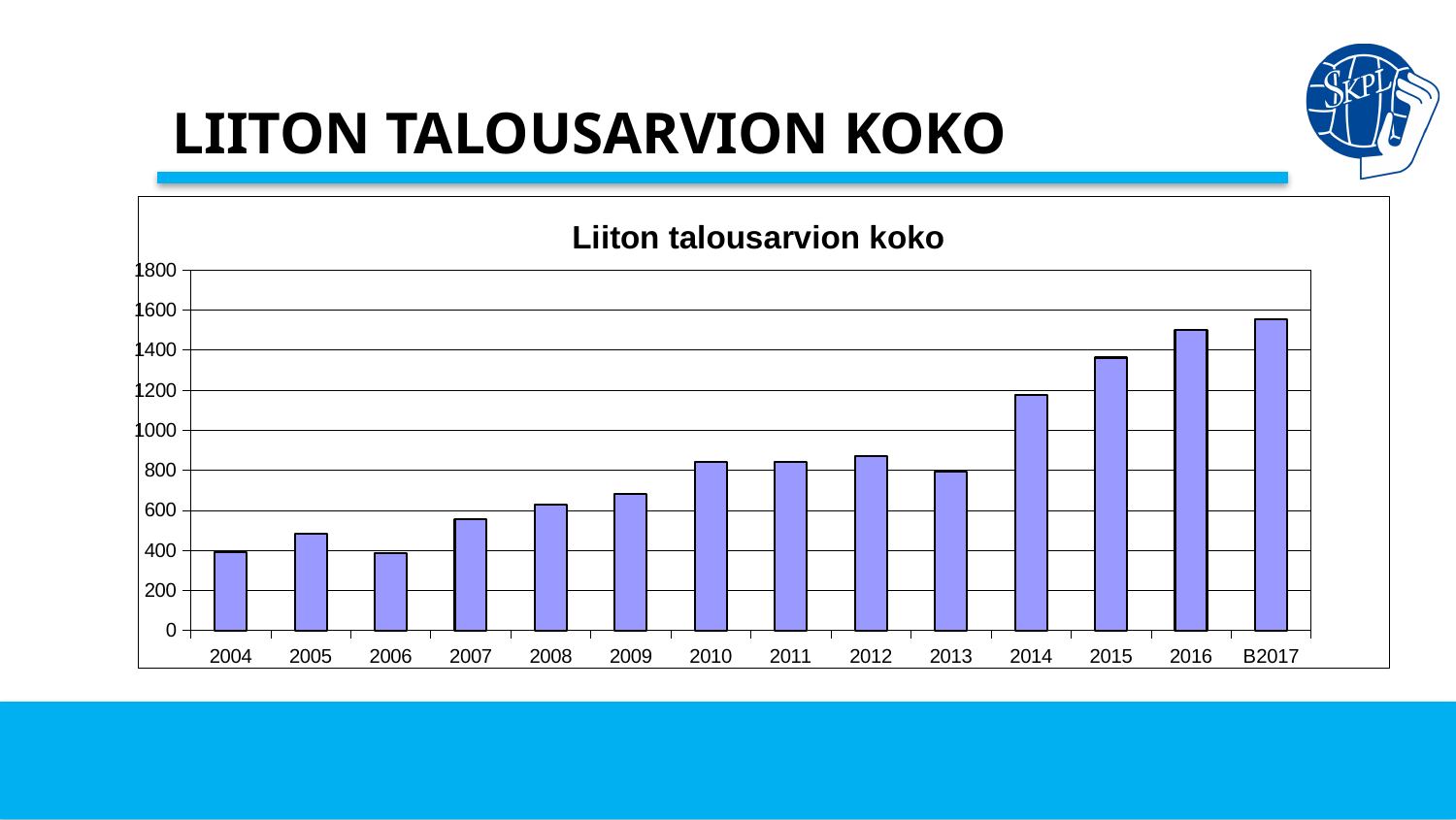
Is the value for 2016 greater or less than 1400? greater Do the values generally rise or fall from 2004 to B2017? Rise Is the value for 2009 greater or less than 800? less Is the value for 2014 greater or less than 1000? greater Which is larger, the value for 2012 or the value for 2013? 2012 Which category has the highest value in the chart? B2017 What kind of chart is shown on the slide? Bar chart How many categories are shown on the x axis of the chart? 14 What is the title of the chart? Liiton talousarvion koko Which is larger, the value for 2015 or the value for 2014? 2015